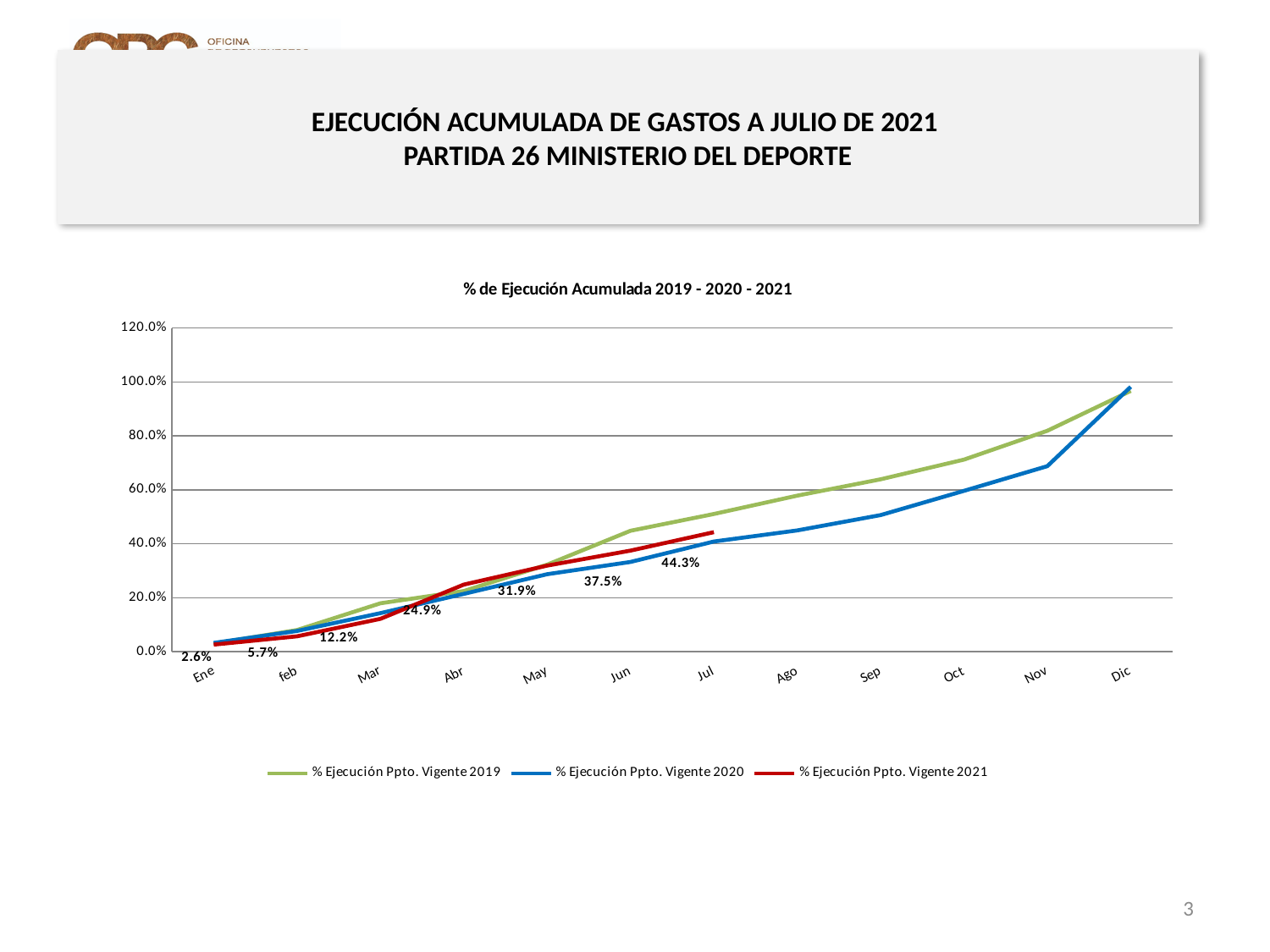
What is the value for % Ejecución Ppto. Vigente 2021 in Jul? 44.3% What is the difference between the Jul and Jun values for % Ejecución Ppto. Vigente 2021? 6.8 percentage points In which month does the % Ejecución Ppto. Vigente 2021 series reach its highest labelled value? Jul How many months are shown on the x axis? 12 In which month does the % Ejecución Ppto. Vigente 2021 series have its lowest value? Ene How many series does the legend list? 3 What is the value for % Ejecución Ppto. Vigente 2021 in May? 31.9% What is the value for % Ejecución Ppto. Vigente 2021 in Abr? 24.9% In Nov, which series is higher: % Ejecución Ppto. Vigente 2019 or % Ejecución Ppto. Vigente 2020? % Ejecución Ppto. Vigente 2019 What is the value for % Ejecución Ppto. Vigente 2021 in Ene? 2.6% What kind of chart is shown on the slide? Line chart Is the value for % Ejecución Ppto. Vigente 2020 in Nov greater or less than 60.0%? greater